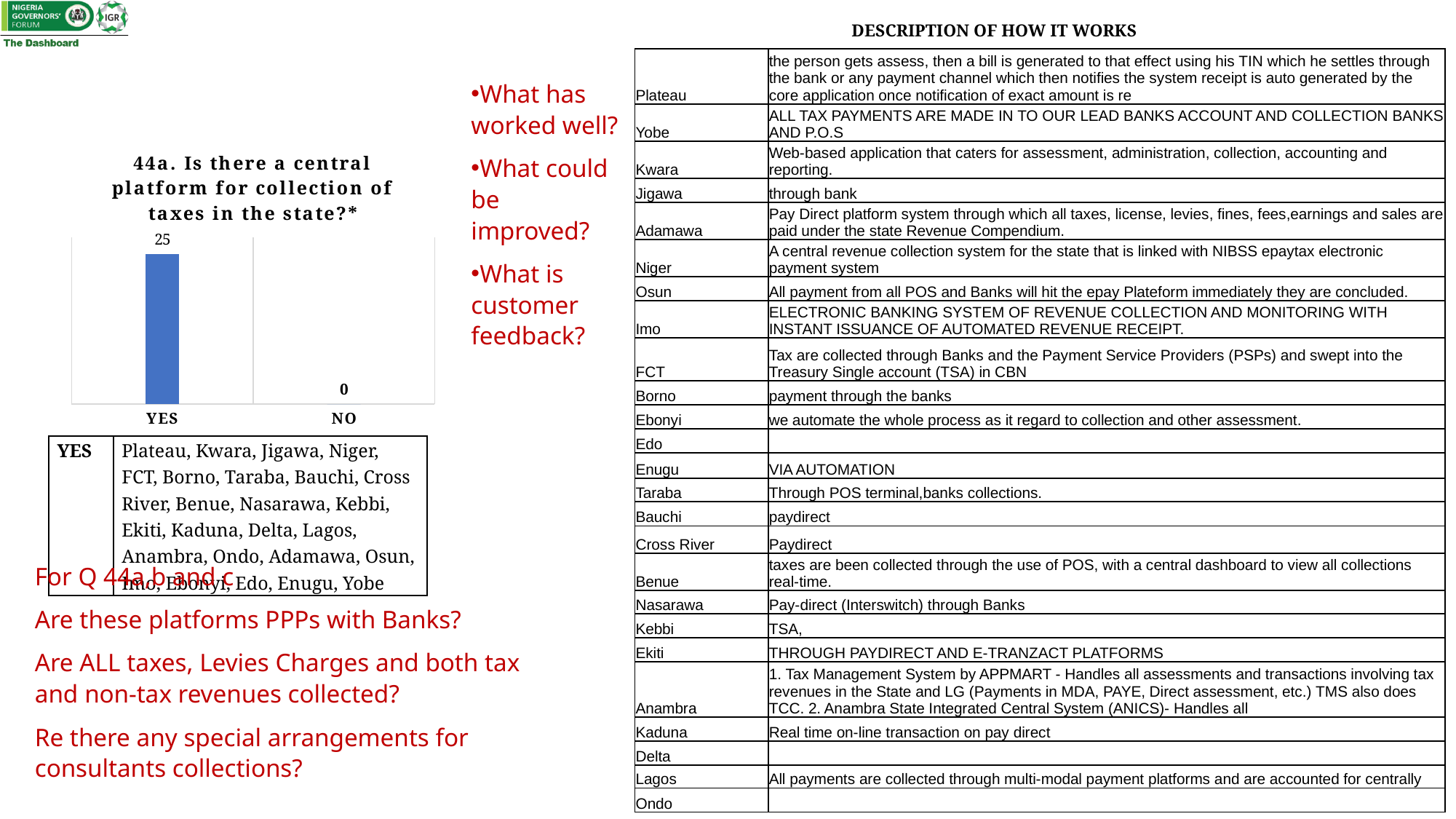
What colour is the YES bar in the chart '44a. Is there a central platform for collection of taxes in the state?*'? blue Which category has the highest value in the chart '44a. Is there a central platform for collection of taxes in the state?*'? YES Which category has the lowest value in the chart '44a. Is there a central platform for collection of taxes in the state?*'? NO What is the difference between the YES and NO values in the chart '44a. Is there a central platform for collection of taxes in the state?*'? 25 What is the total of the YES and NO values in the chart '44a. Is there a central platform for collection of taxes in the state?*'? 25 How many categories are shown in the chart '44a. Is there a central platform for collection of taxes in the state?*'? 2 In the chart '44a. Is there a central platform for collection of taxes in the state?*', which is larger, YES or NO? YES What is the title of the bar chart on the slide? 44a. Is there a central platform for collection of taxes in the state?* What is the value for YES in the chart '44a. Is there a central platform for collection of taxes in the state?*'? 25 What kind of chart is '44a. Is there a central platform for collection of taxes in the state?*'? bar chart What is the value for NO in the chart '44a. Is there a central platform for collection of taxes in the state?*'? 0